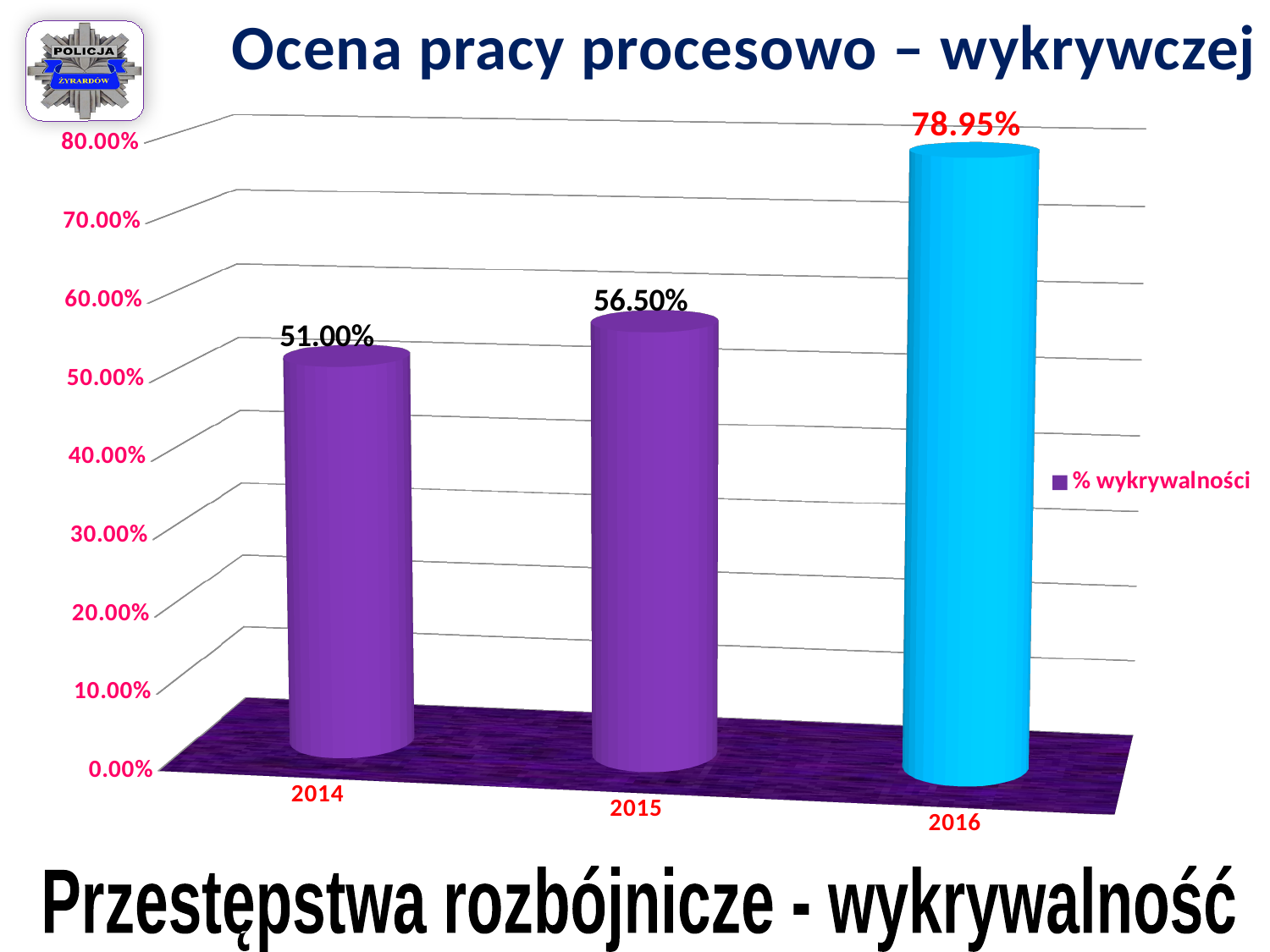
What is the % wykrywalności value for 2016? 78.95% Is the value for 2016 greater or less than 70.00%? greater Which year has the lowest % wykrywalności? 2014 What is the % wykrywalności value for 2014? 51.00% What is the % wykrywalności value for 2015? 56.50% Do the values rise or fall from 2014 to 2016? rise Which year has the highest % wykrywalności? 2016 How many years are shown on the x axis? 3 What is the difference between the 2016 and 2015 values? 22.45% Which is larger, the value for 2015 or the value for 2014? 2015 What kind of chart is shown on the slide? bar chart What is the difference between the 2015 and 2014 values? 5.50%